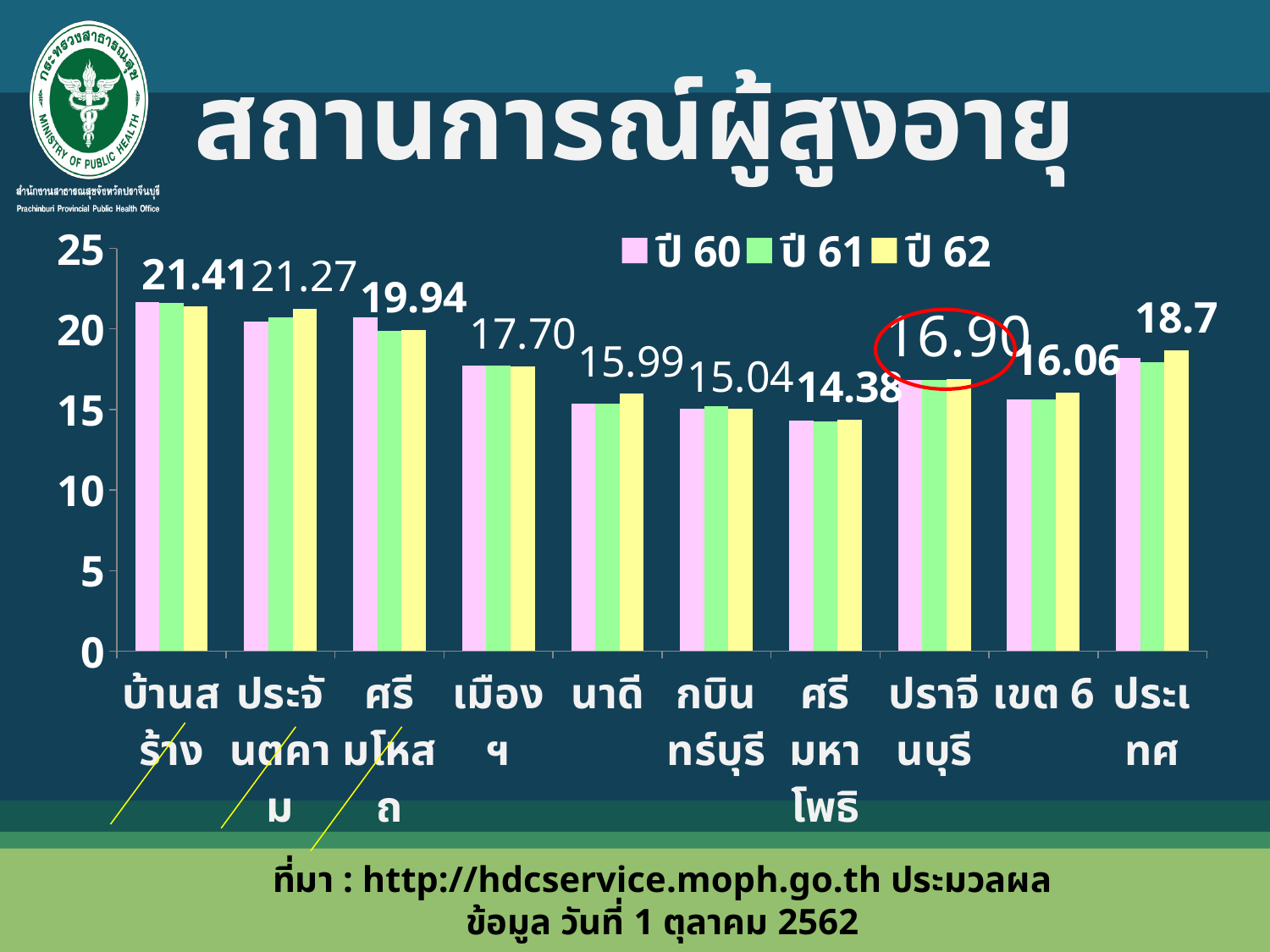
How many categories are shown on the x axis? 10 What value is labelled for ประเทศ? 18.7 Is the ปี 60 value for เมืองฯ greater or less than 15? greater How many series does the legend list? 3 What kind of chart is shown on the slide? bar chart Which category has the highest labelled value? บ้านสร้าง Which category has the lowest labelled value? ศรีมหาโพธิ What value is labelled for บ้านสร้าง? 21.41 Which has the larger labelled value, นาดี or เขต 6? เขต 6 What value is labelled for ปราจีนบุรี? 16.90 What value is labelled for ศรีมโหสถ? 19.94 What is the difference between the labelled values for บ้านสร้าง and ศรีมหาโพธิ? 7.03